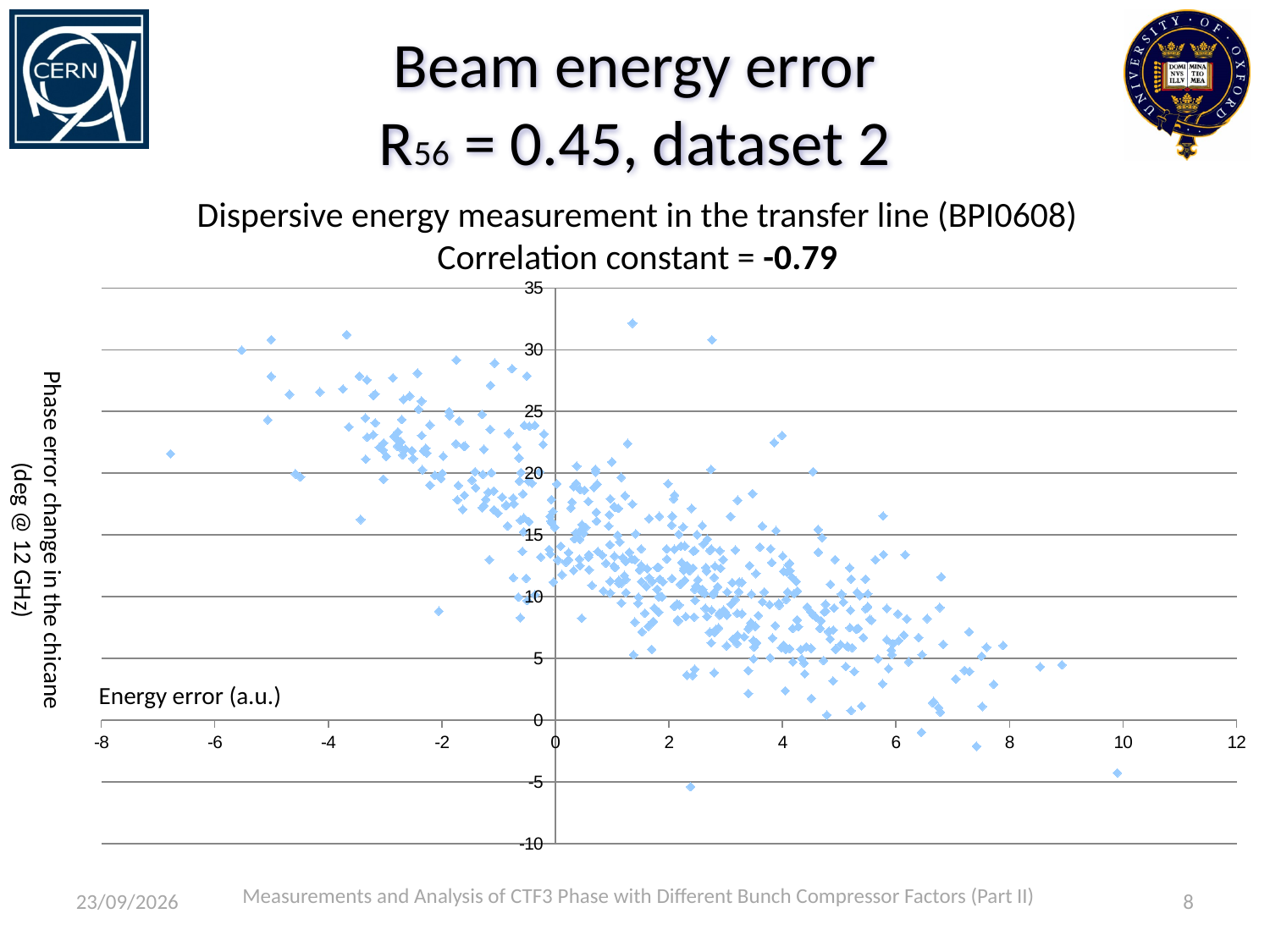
What is the label of the y axis of the chart? Phase error change in the chicane (deg @ 12 GHz) As the energy error increases along the x axis, does the phase error change generally rise or fall? fall What is the label of the x axis of the chart? Energy error (a.u.) What is the spacing between consecutive tick labels on the y axis of the chart? 5 What is the minimum value shown on the y axis of the chart? -10 What is the minimum value shown on the x axis of the chart? -8 What kind of chart is shown on the slide? scatter plot Is the phase error change of the point plotted near an energy error of 10 greater or less than 0? less What is the maximum value shown on the x axis of the chart? 12 Is the highest phase error change value plotted on the chart greater or less than 30? greater What is the maximum value shown on the y axis of the chart? 35 How many data series are plotted on the chart? 1